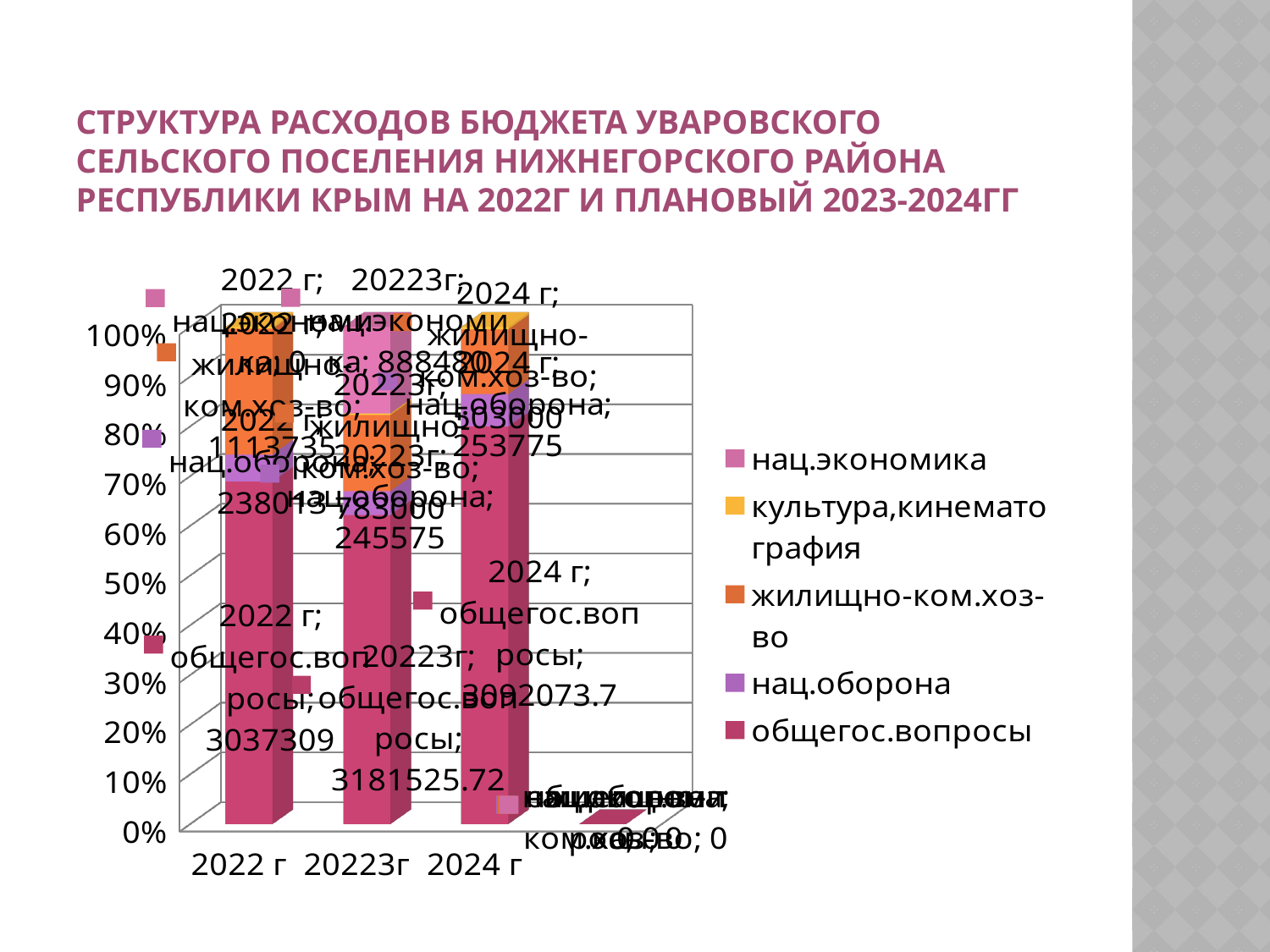
Which series is shown at the bottom of each stacked bar? общегос.вопросы What is the value of нац.оборона for 2022 г? 238013 What is the value of нац.оборона for 2024 г? 253775 How many series does the chart legend list? 5 What is the value of общегос.вопросы for 2024 г? 3092073.7 What is the value of нац.оборона for 20223г? 245575 What is the value of общегос.вопросы for 20223г? 3181525.72 Which year has the larger общегос.вопросы value, 20223г or 2024 г? 20223г How many categories (years) are shown on the x axis of the chart? 3 What is the value of общегос.вопросы for 2022 г? 3037309 What is the difference between the нац.оборона values for 2024 г and 2022 г? 15762 What kind of chart is shown on the slide? bar chart